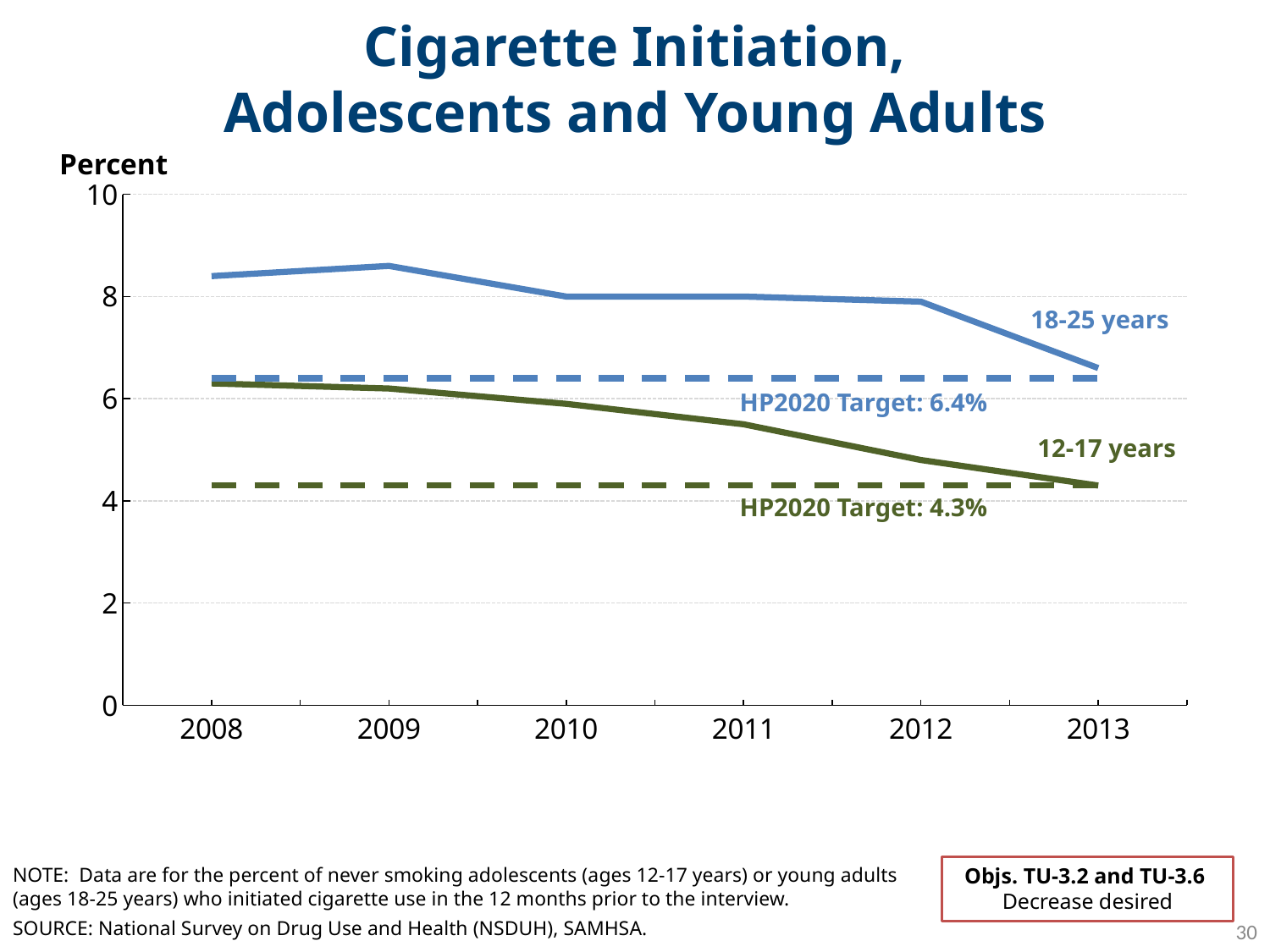
Is the value for 18-25 years in 2013 greater or less than 6? greater What is the difference between the HP2020 target for 18-25 years and the HP2020 target for 12-17 years? 2.1 percentage points Does the 18-25 years line rise or fall overall from 2008 to 2013? Fall What is the HP2020 target for the 12-17 years group? 4.3% Does the 12-17 years line rise or fall from 2008 to 2013? Fall Is the value for 12-17 years in 2011 greater or less than 6? less What kind of chart is shown on the slide? Line chart In which year is the 18-25 years line at its lowest? 2013 In 2010, which group has the higher value, 18-25 years or 12-17 years? 18-25 years What is the HP2020 target for the 18-25 years group? 6.4% Is the value for 18-25 years in 2008 greater or less than 8? greater How many years are plotted along the x axis? 6